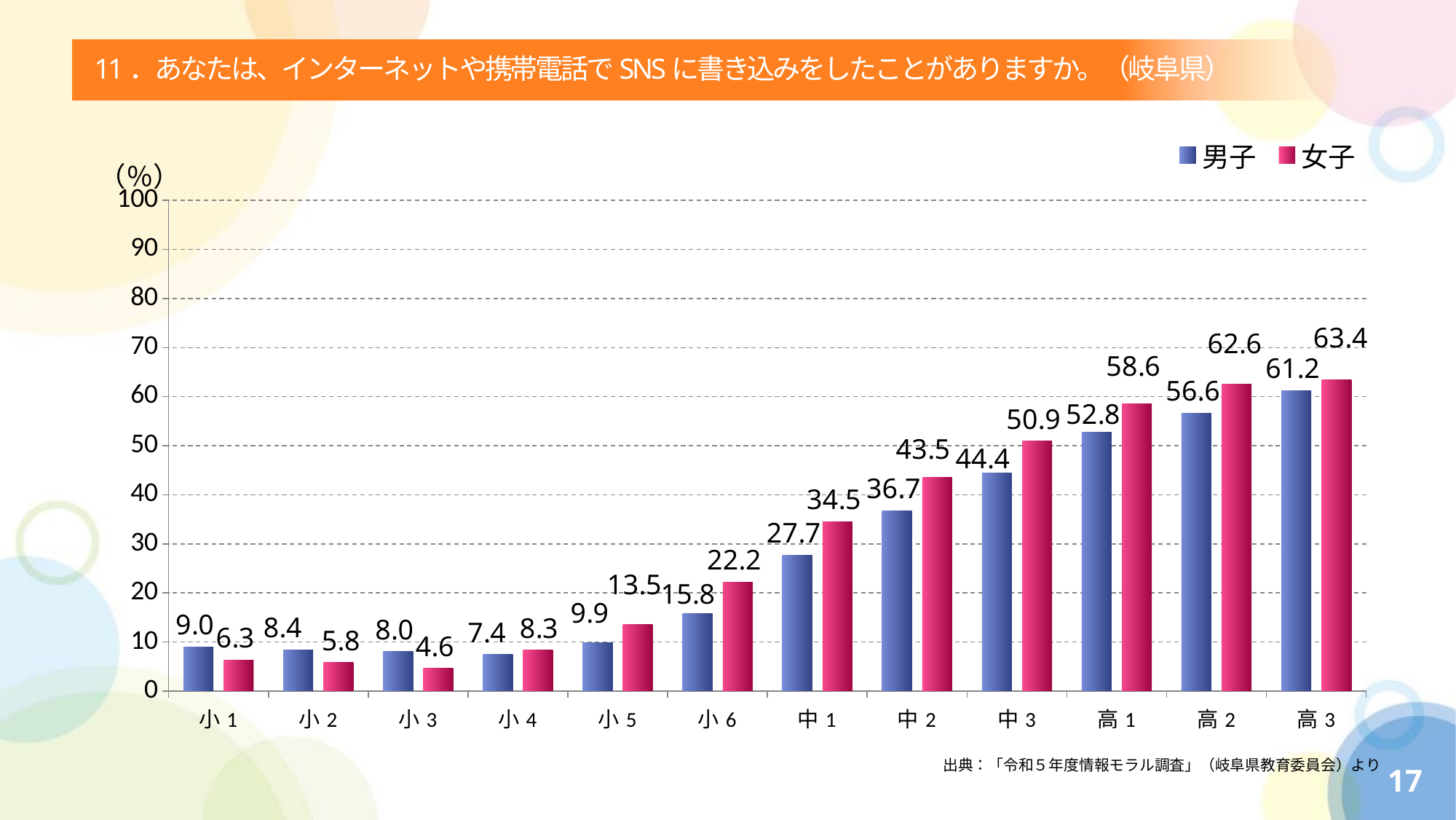
Do the values for 女子 generally rise or fall from 小4 to 高3? rise What is the value for 女子 at 小3? 4.6 What is the value for 男子 at 中1? 27.7 What kind of chart is this? bar chart What is the difference between 女子 and 男子 at 中2? 6.8 Which category has the highest value for 男子? 高3 What is the value for 女子 at 高3? 63.4 Which is larger at 小1, 男子 or 女子? 男子 How many series does the legend list? 2 How many categories are shown on the x axis? 12 Is the value for 女子 at 中3 greater or less than 50? greater Which category has the lowest value for 女子? 小3